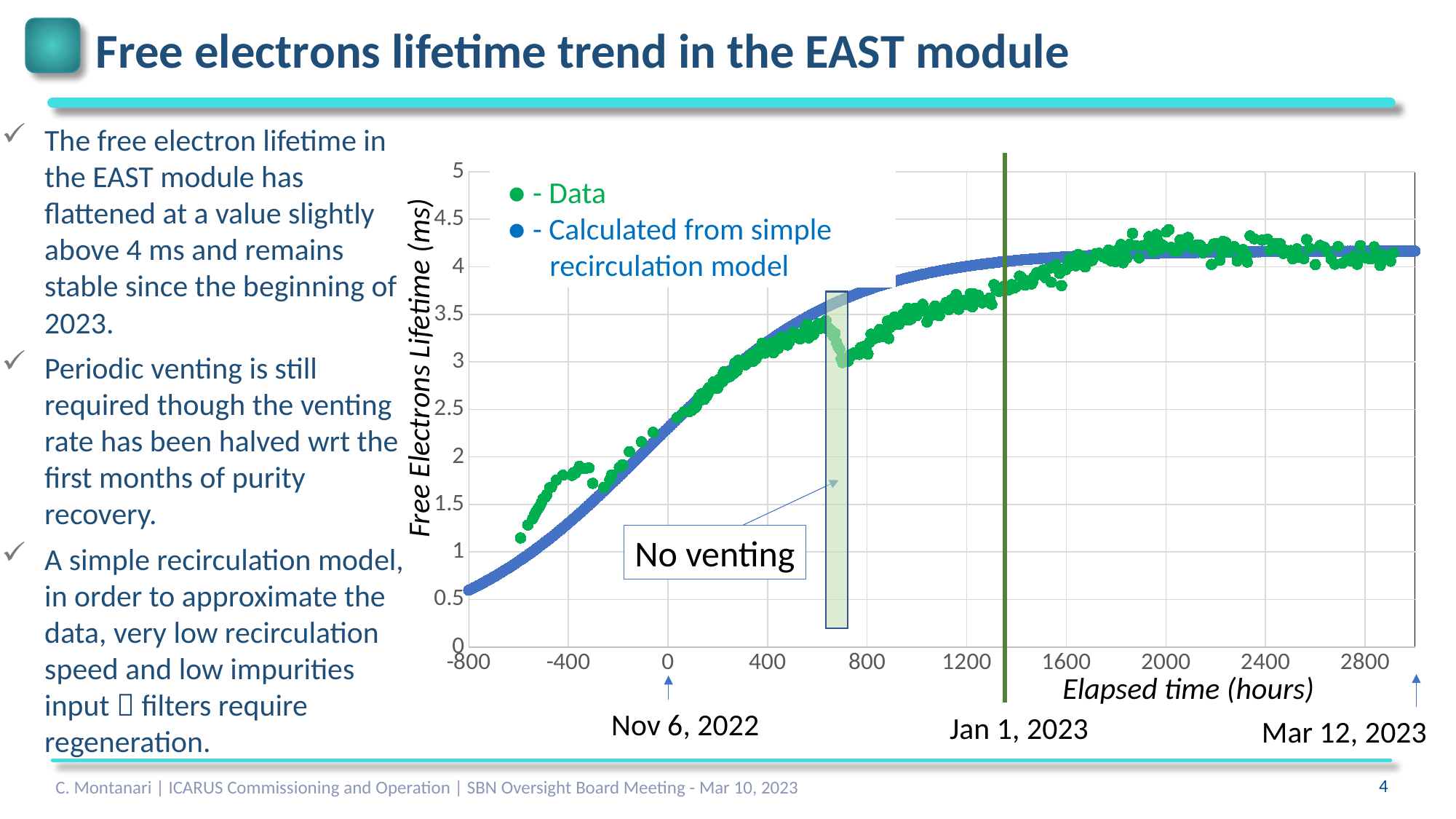
Do the Data values generally rise or fall as elapsed time increases? rise Is the Data value at 2000 hours of elapsed time greater or less than 4? greater How many series does the chart legend list? 2 Is the value calculated from the simple recirculation model at -800 hours greater or less than 1? less What is the title of the y axis of the chart? Free Electrons Lifetime (ms) Which series is higher at 2000 hours of elapsed time, Data or the simple recirculation model? Data Is the value calculated from the simple recirculation model at 2800 hours greater or less than 4? greater What kind of chart is shown on the slide? scatter chart What is the title of the x axis of the chart? Elapsed time (hours)